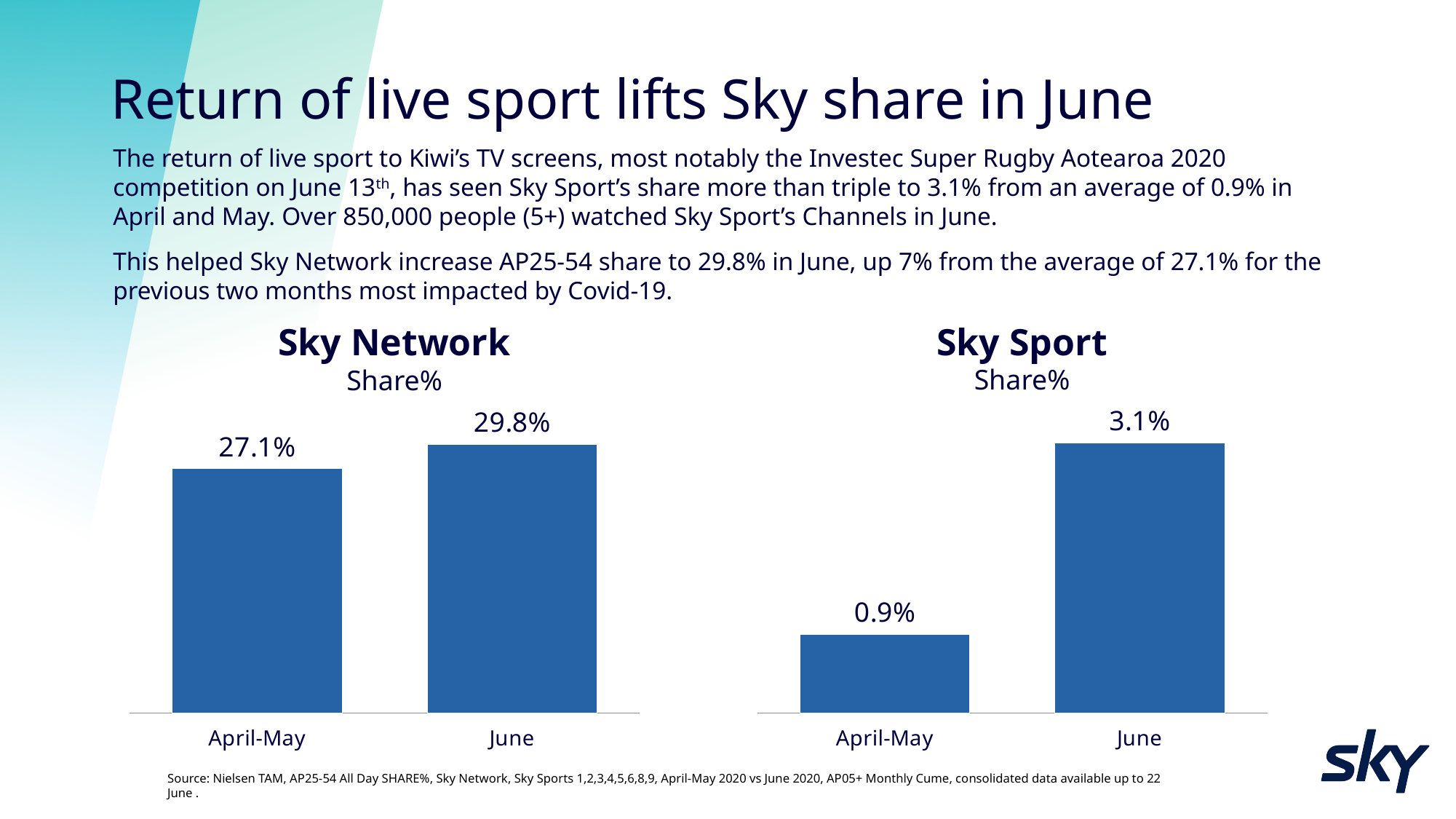
In the Sky Sport chart, what is the difference between the June and April-May shares? 2.2% How many categories are shown on the x axis of the Sky Network chart? 2 What kind of chart is the Sky Sport chart? bar chart In the Sky Sport chart, which period has the lower share? April-May In the Sky Sport chart, what is the share for April-May? 0.9% In the Sky Network chart, do the values rise or fall from April-May to June? rise In the Sky Network chart, what is the difference between the June and April-May shares? 2.7% In the Sky Sport chart, what is the share for June? 3.1% In the Sky Network chart, what is the share for June? 29.8% In the Sky Sport chart, is the share for June larger or smaller than the share for April-May? larger In the Sky Network chart, what is the share for April-May? 27.1% In the Sky Network chart, which period has the higher share? June